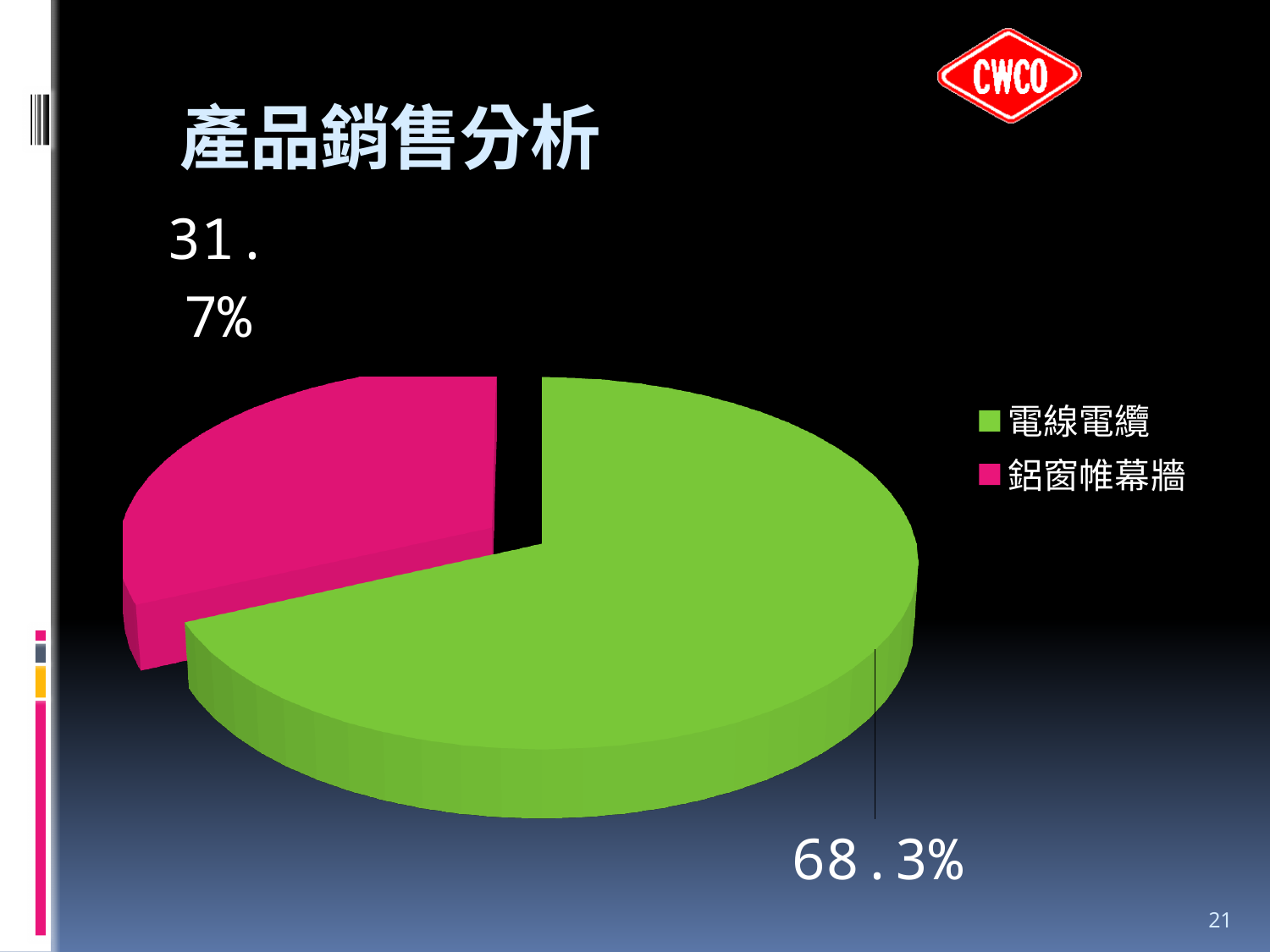
Which category has the largest slice of the pie? 電線電纜 What colour is the slice for 鋁窗帷幕牆? magenta (pink) What is the difference in percentage points between the 電線電纜 slice and the 鋁窗帷幕牆 slice? 36.6 How many categories are shown in the pie chart? 2 How many entries does the legend list? 2 What share of the pie does 鋁窗帷幕牆 account for? 31.7% Which is larger, the slice for 電線電纜 or the slice for 鋁窗帷幕牆? 電線電纜 What is the title of the slide containing the pie chart? 產品銷售分析 What kind of chart is shown on the slide? pie chart Which category has the smallest slice of the pie? 鋁窗帷幕牆 What share of the pie does 電線電纜 account for? 68.3%